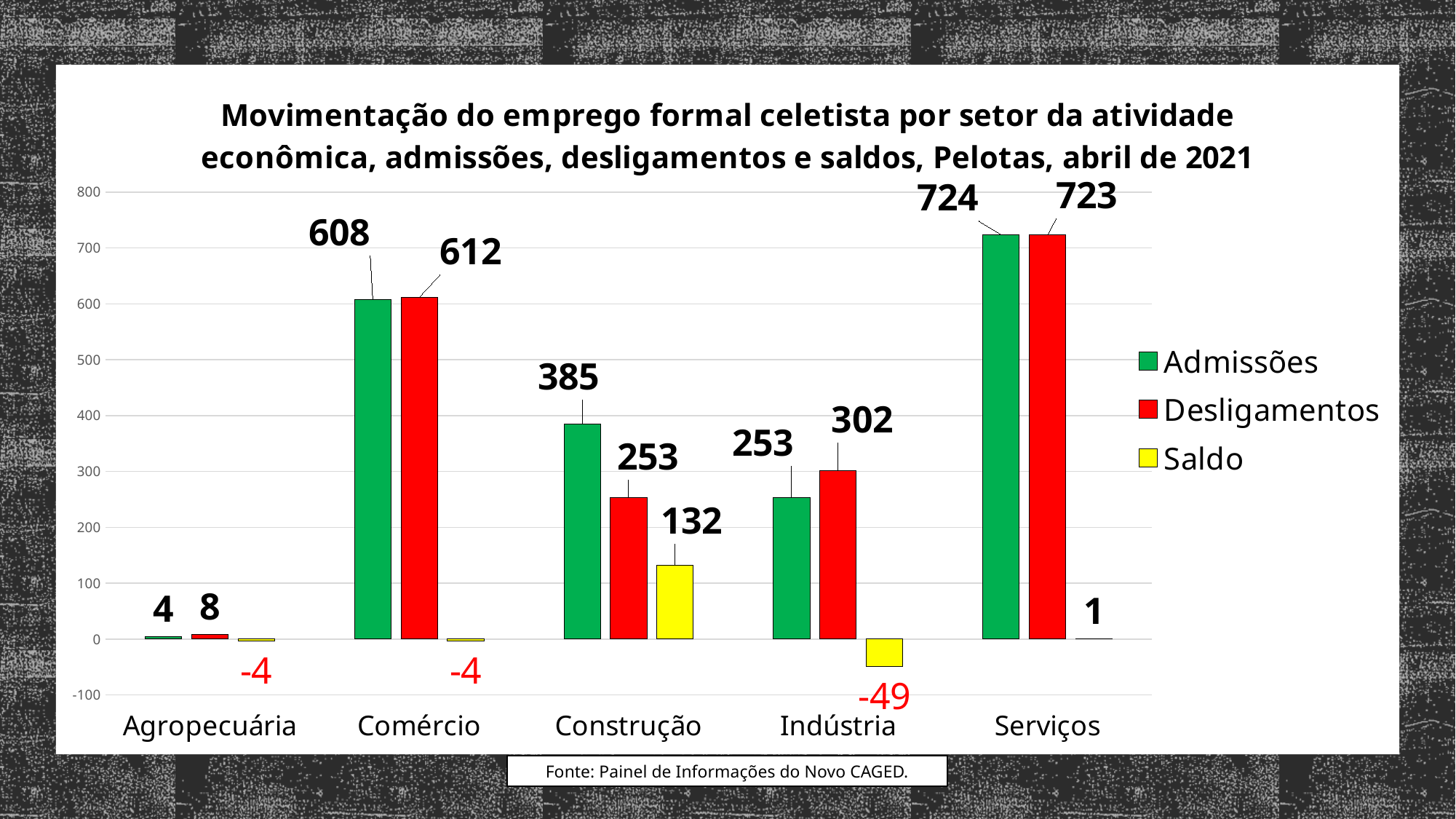
How many sectors are shown on the x axis? 5 Which is larger for Comércio, Admissões or Desligamentos? Desligamentos What colour represents the Saldo series? Yellow What is the value of Admissões for Comércio? 608 How many series does the legend list? 3 What kind of chart is shown on the slide? Bar chart What is the Saldo value for Construção? 132 What is the difference between Admissões and Desligamentos for Construção? 132 Which sector has the highest Admissões value? Serviços Which sector has the lowest Desligamentos value? Agropecuária What is the Saldo value for Indústria? -49 What is the value of Desligamentos for Indústria? 302